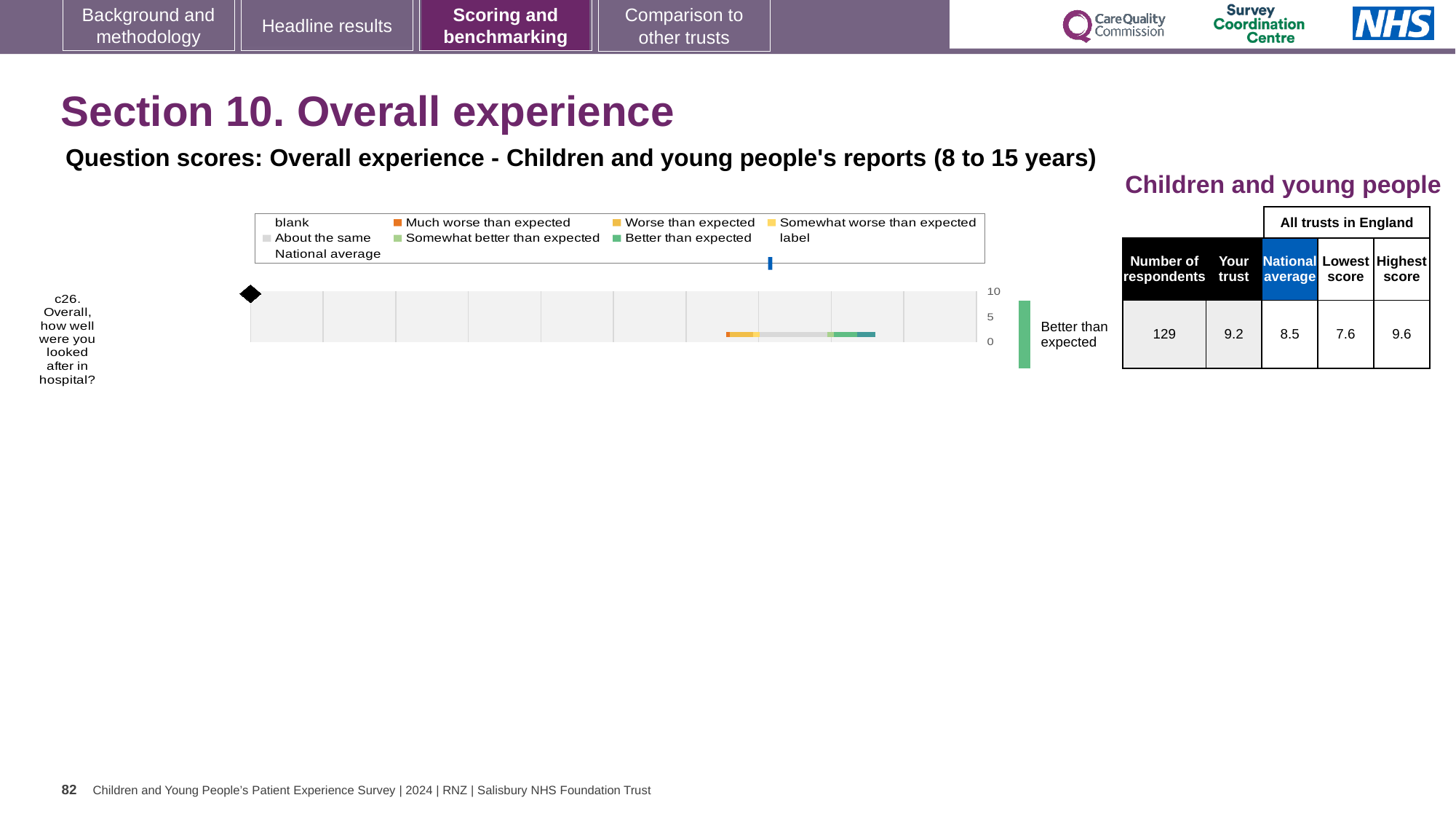
Which question is plotted on the chart? c26. Overall, how well were you looked after in hospital? What is the difference between the 'Your trust' score and the national average for question c26? 0.7 What benchmark category is shown to the right of the chart for question c26? Better than expected What kind of chart is used to show the question score for c26? bar chart How many questions are plotted on the chart? 1 What is the highest score among all trusts in England for question c26? 9.6 What is the national average score for question c26? 8.5 What is the 'Your trust' score for question c26? 9.2 What is the lowest score among all trusts in England for question c26? 7.6 What is the difference between the highest score and the lowest score for question c26? 2.0 Which is higher for question c26: the 'Your trust' score or the national average? Your trust How many respondents answered question c26? 129